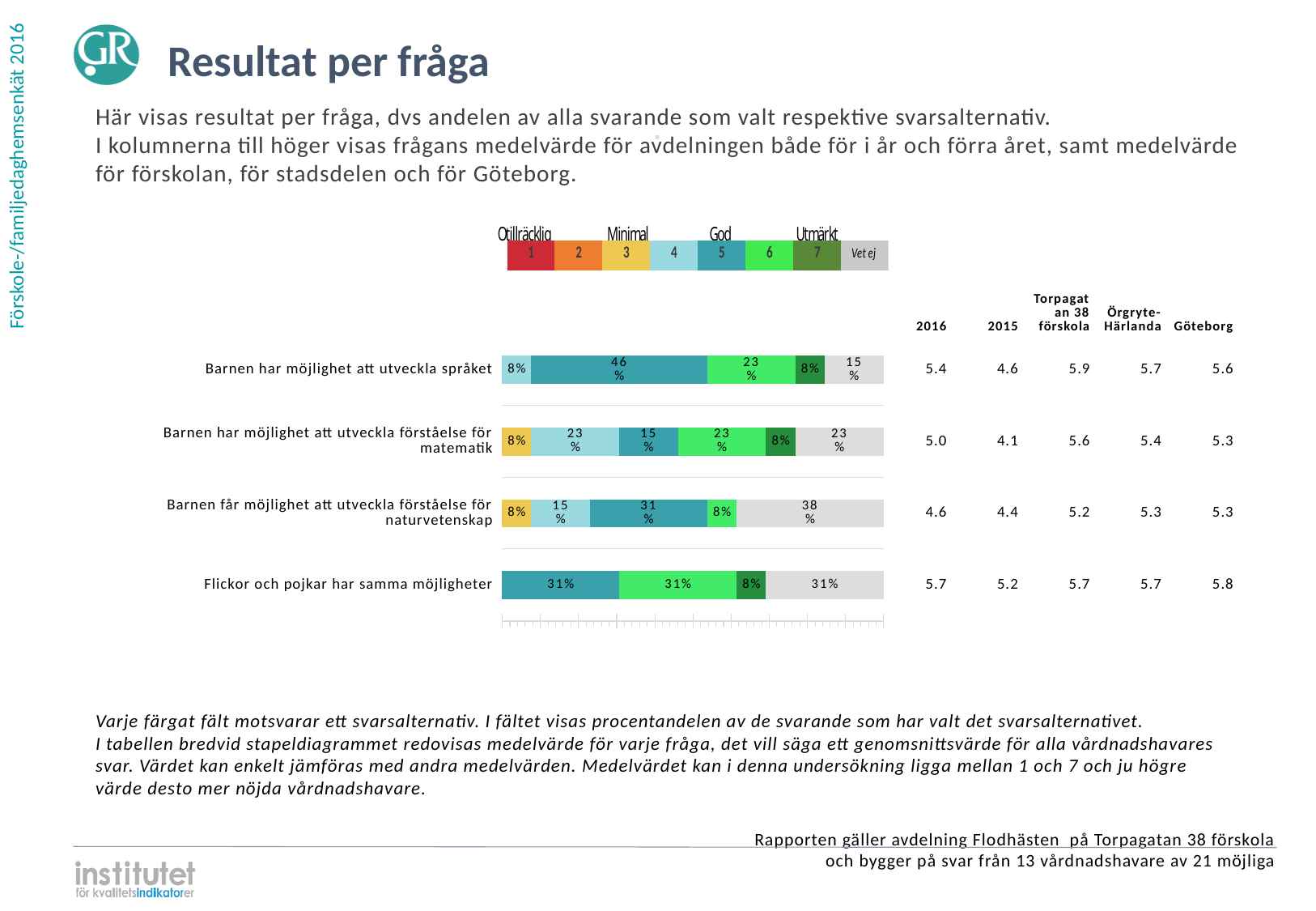
Which question has the largest 'Vet ej' share? Barnen får möjlighet att utveckla förståelse för naturvetenskap What percentage of respondents chose option 5 (teal) for 'Barnen har möjlighet att utveckla språket'? 46% Which question has the smallest 'Vet ej' share? Barnen har möjlighet att utveckla språket What kind of chart is used to show the results per question? Stacked bar chart How many questions (categories) are shown as bars in the chart? 4 What percentage chose option 6 (bright green) for 'Flickor och pojkar har samma möjligheter'? 31% What percentage chose 'Vet ej' for 'Barnen får möjlighet att utveckla förståelse för naturvetenskap'? 38% What is the 2016 mean value shown for 'Flickor och pojkar har samma möjligheter'? 5.7 Which is larger: the option 6 share for 'Barnen har möjlighet att utveckla språket' or for 'Barnen får möjlighet att utveckla förståelse för naturvetenskap'? Barnen har möjlighet att utveckla språket How many response options does the legend above the chart list? 8 What percentage chose option 3 (yellow) for 'Barnen har möjlighet att utveckla förståelse för matematik'? 8% What is the difference between the option 5 share for 'Barnen har möjlighet att utveckla språket' (46%) and for 'Barnen har möjlighet att utveckla förståelse för matematik' (15%)? 31%